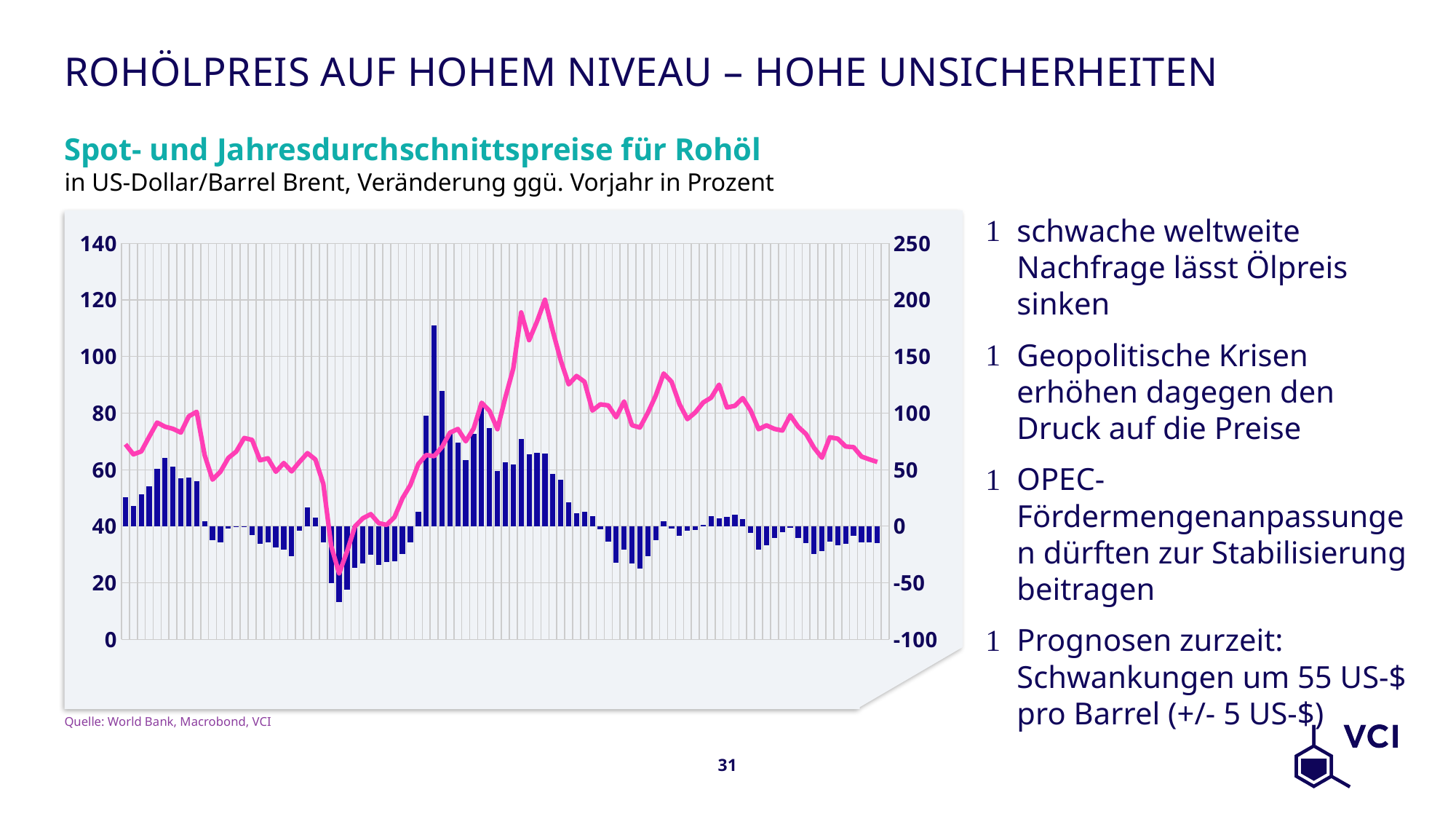
What kind of chart is shown on the slide? A combined bar and line chart What is the title of the chart? Spot- und Jahresdurchschnittspreise für Rohöl Is the highest point of the pink line greater or less than 140 on the left axis? less Is the tallest bar greater or less than 150 on the right axis? greater What source is cited below the chart? World Bank, Macrobond, VCI Are the bars at the far right of the chart above or below zero on the right axis? below Toward the right end of the chart, is the pink line rising or falling? falling